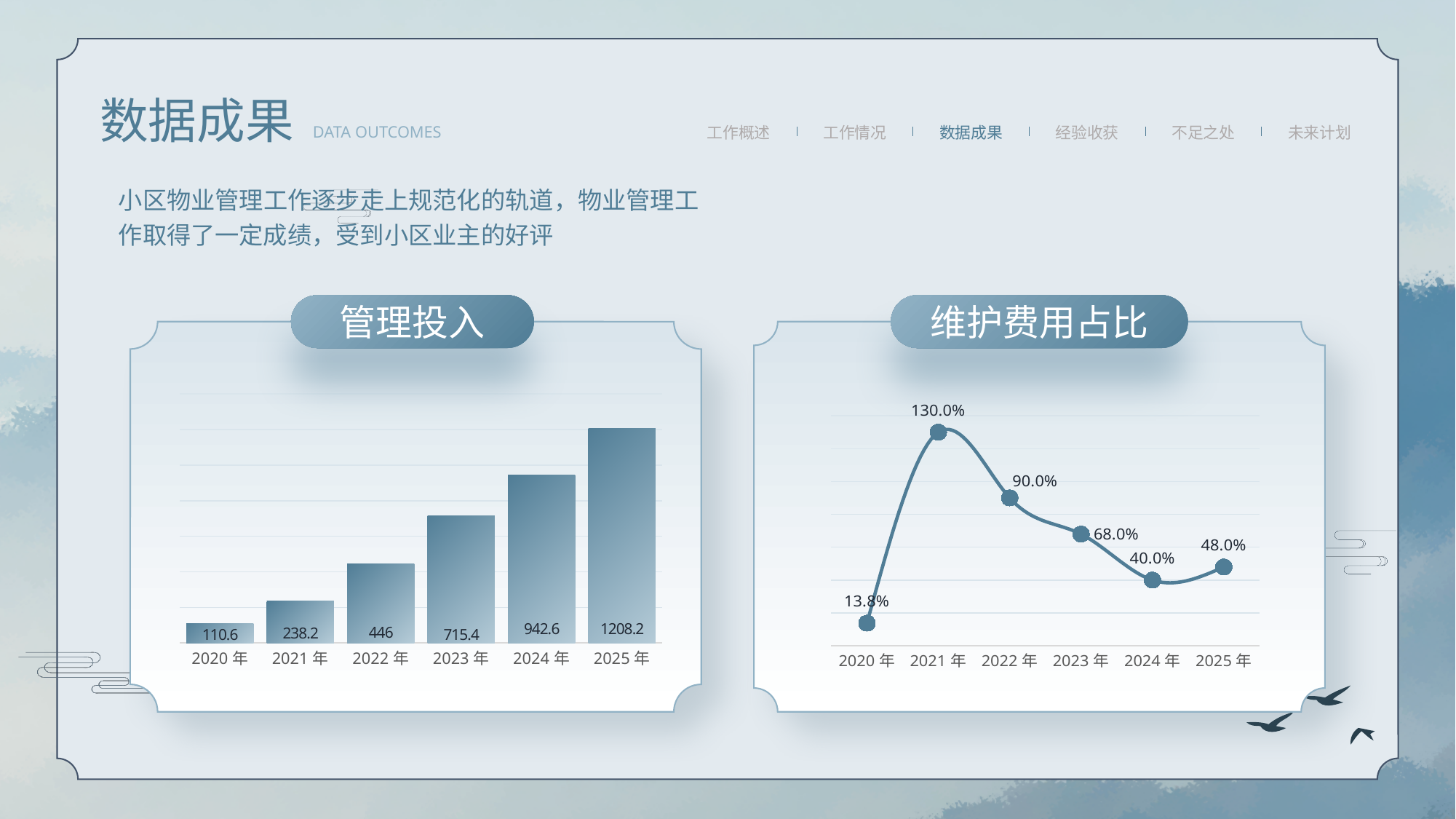
What kind of chart is the 维护费用占比 chart? line chart In the 管理投入 chart, what is the value for 2025 年? 1208.2 In the 维护费用占比 chart, which year has the highest value? 2021 年 In the 维护费用占比 chart, what is the value for 2020 年? 13.8% In the 管理投入 chart, do the values rise or fall from 2020 年 to 2025 年? rise In the 管理投入 chart, which year has the lowest value? 2020 年 How many years are shown in the 管理投入 chart? 6 In the 维护费用占比 chart, what is the value for 2021 年? 130.0% In the 管理投入 chart, what is the value for 2022 年? 446 In the 管理投入 chart, what is the difference between the values for 2024 年 and 2023 年? 227.2 In the 维护费用占比 chart, which is larger, the value for 2024 年 or 2025 年? 2025 年 What kind of chart is the 管理投入 chart? bar chart